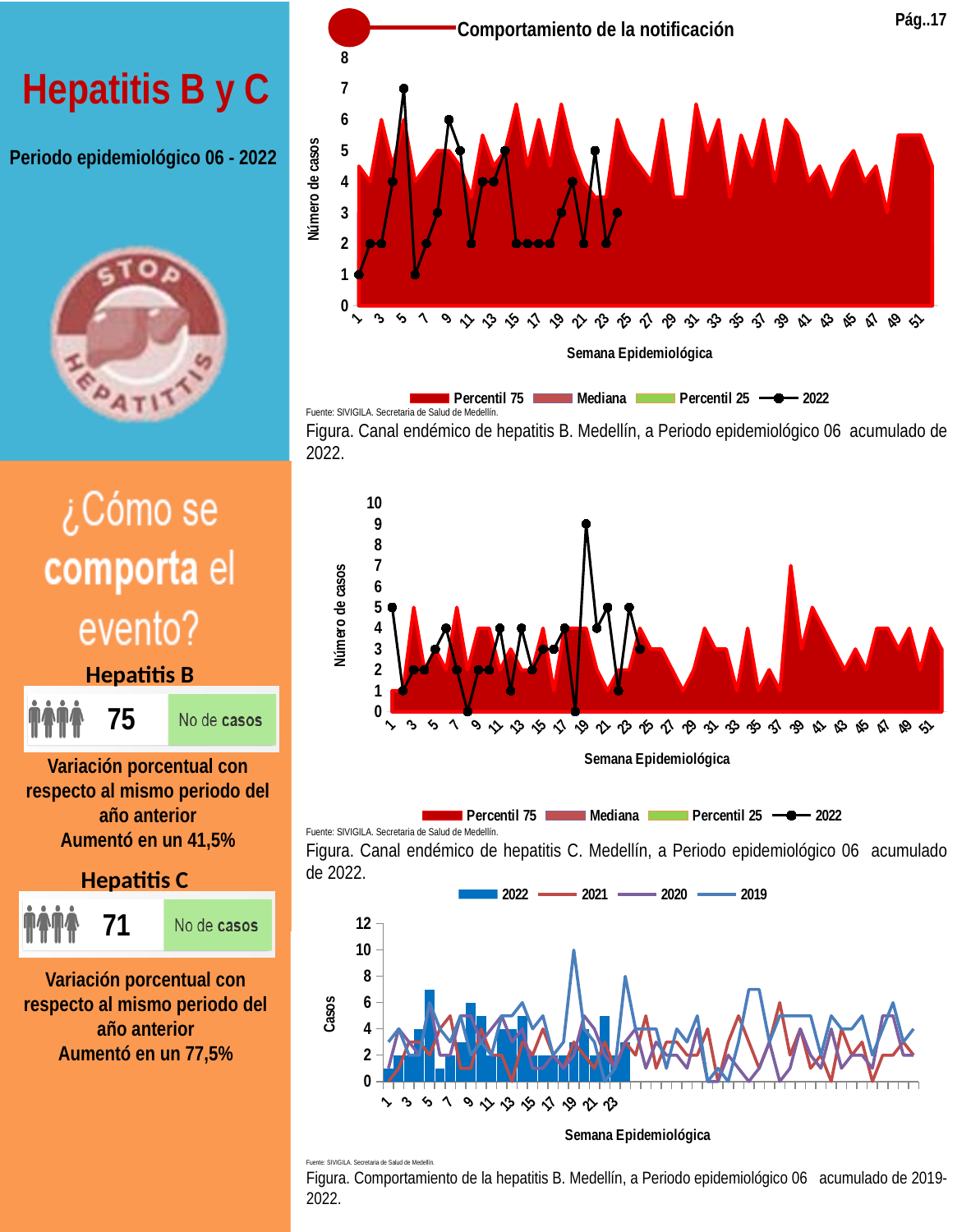
In the chart titled 'Canal endémico de hepatitis B', is the 2022 value at week 5 larger or smaller than the 2022 value at week 6? larger In the chart titled 'Canal endémico de hepatitis B', what is the 2022 value at epidemiological week 1? 1 In the chart titled 'Canal endémico de hepatitis C', what is the 2022 value at epidemiological week 19? 9 In the chart titled 'Canal endémico de hepatitis C', at which epidemiological week does the 2022 line reach its highest value? 19 In the bottom chart (Comportamiento de la hepatitis B, 2019-2022), is the 2019 value at epidemiological week 19 greater or less than 8? greater In the chart titled 'Canal endémico de hepatitis C', what is the label of the x axis? Semana Epidemiológica In the bottom chart (Comportamiento de la hepatitis B, 2019-2022), how many series does the legend list? 4 In the chart titled 'Canal endémico de hepatitis C', what is the 2022 value at epidemiological week 8? 0 In the chart titled 'Canal endémico de hepatitis B', what is the 2022 value at epidemiological week 5? 7 In the chart titled 'Canal endémico de hepatitis B', what kind of chart is used to show the 2022 series? line chart In the chart titled 'Canal endémico de hepatitis B', at which epidemiological week does the 2022 line reach its highest value? 5 In the chart titled 'Canal endémico de hepatitis B', how many series does the legend list? 4